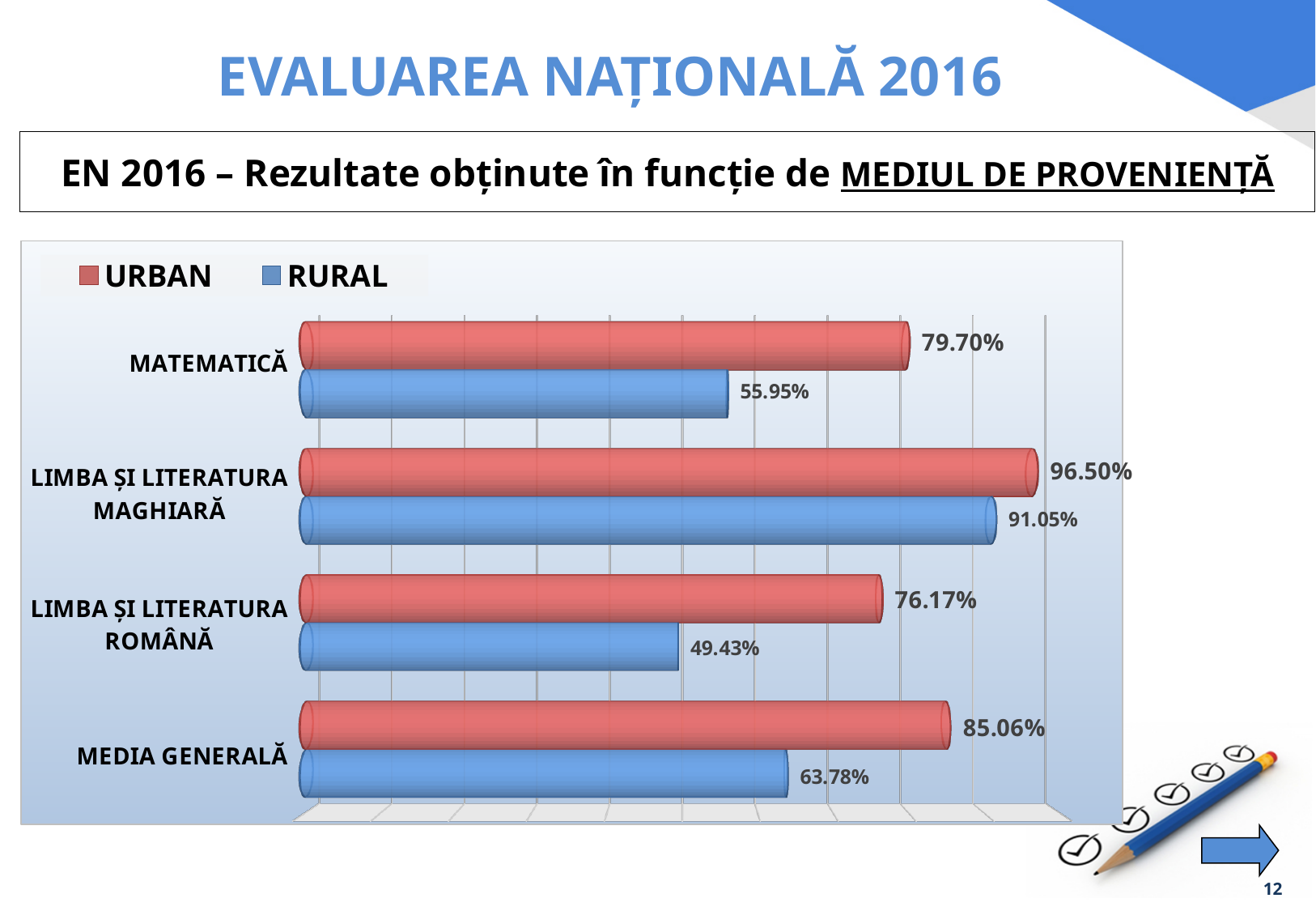
What is the difference between the URBAN and RURAL values for LIMBA ȘI LITERATURA MAGHIARĂ? 5.45% Which category has the highest RURAL value? LIMBA ȘI LITERATURA MAGHIARĂ How many categories are shown on the chart? 4 What is the RURAL value for LIMBA ȘI LITERATURA ROMÂNĂ? 49.43% What is the difference between the URBAN and RURAL values for MATEMATICĂ? 23.75% Which is larger for MEDIA GENERALĂ, the URBAN value or the RURAL value? URBAN How many series does the legend list? 2 What is the RURAL value for MEDIA GENERALĂ? 63.78% What is the URBAN value for LIMBA ȘI LITERATURA MAGHIARĂ? 96.50% What is the URBAN value for MATEMATICĂ? 79.70% What kind of chart is shown on the slide? Bar chart Which category has the lowest URBAN value? LIMBA ȘI LITERATURA ROMÂNĂ